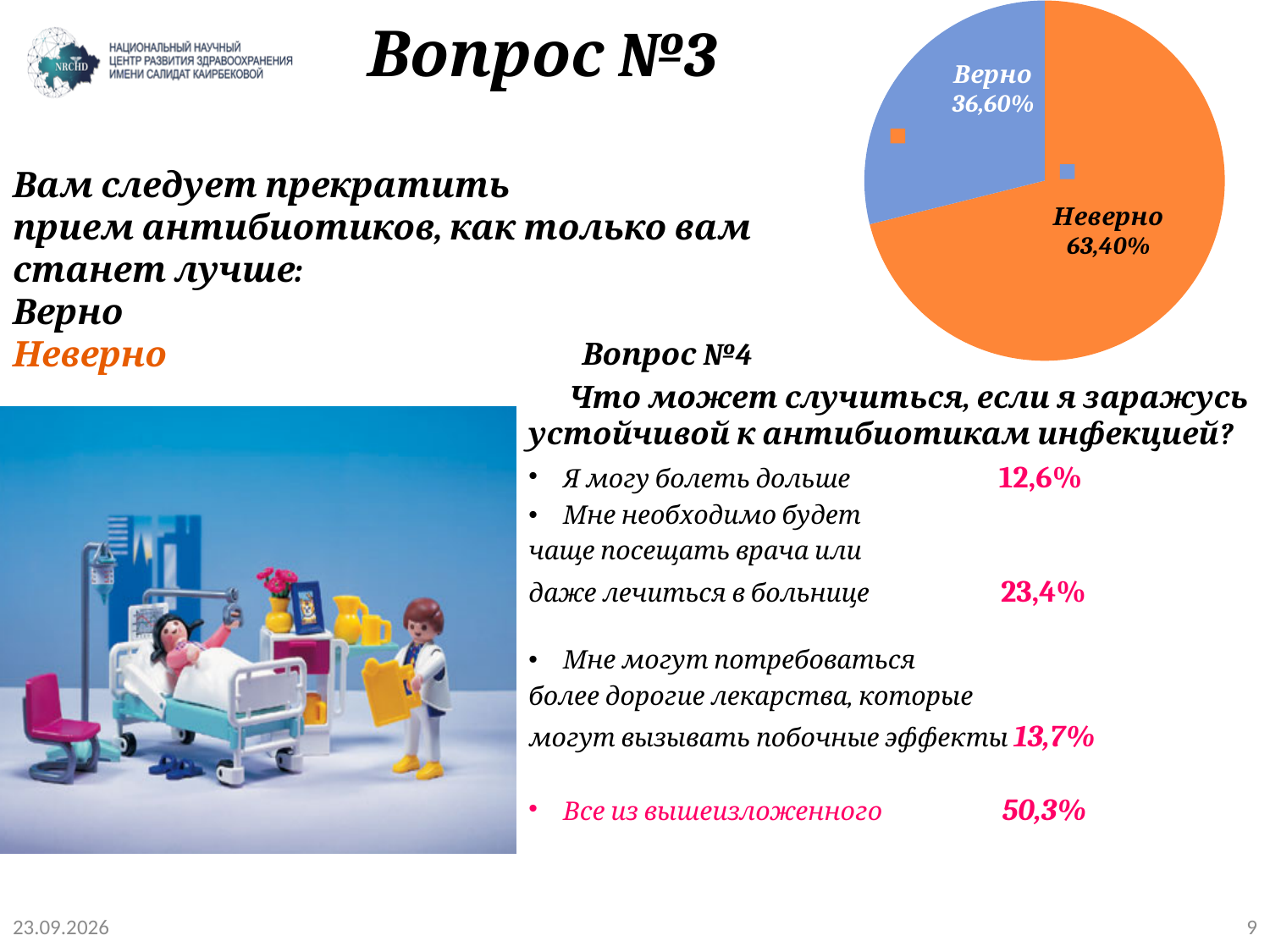
What colour is the Неверно slice in the pie chart? orange How many slices does the pie chart have? 2 What is the value for Верно in the pie chart? 36,60% Which slice of the pie chart is the largest? Неверно What is the difference between the Неверно and Верно values in the pie chart? 26,80% Which is larger in the pie chart, Верно or Неверно? Неверно What is the value for Неверно in the pie chart? 63,40% What share of the pie does the Неверно slice take? 63,40% Which slice of the pie chart is the smallest? Верно What kind of chart is shown on the slide? pie chart What colour is the Верно slice in the pie chart? blue